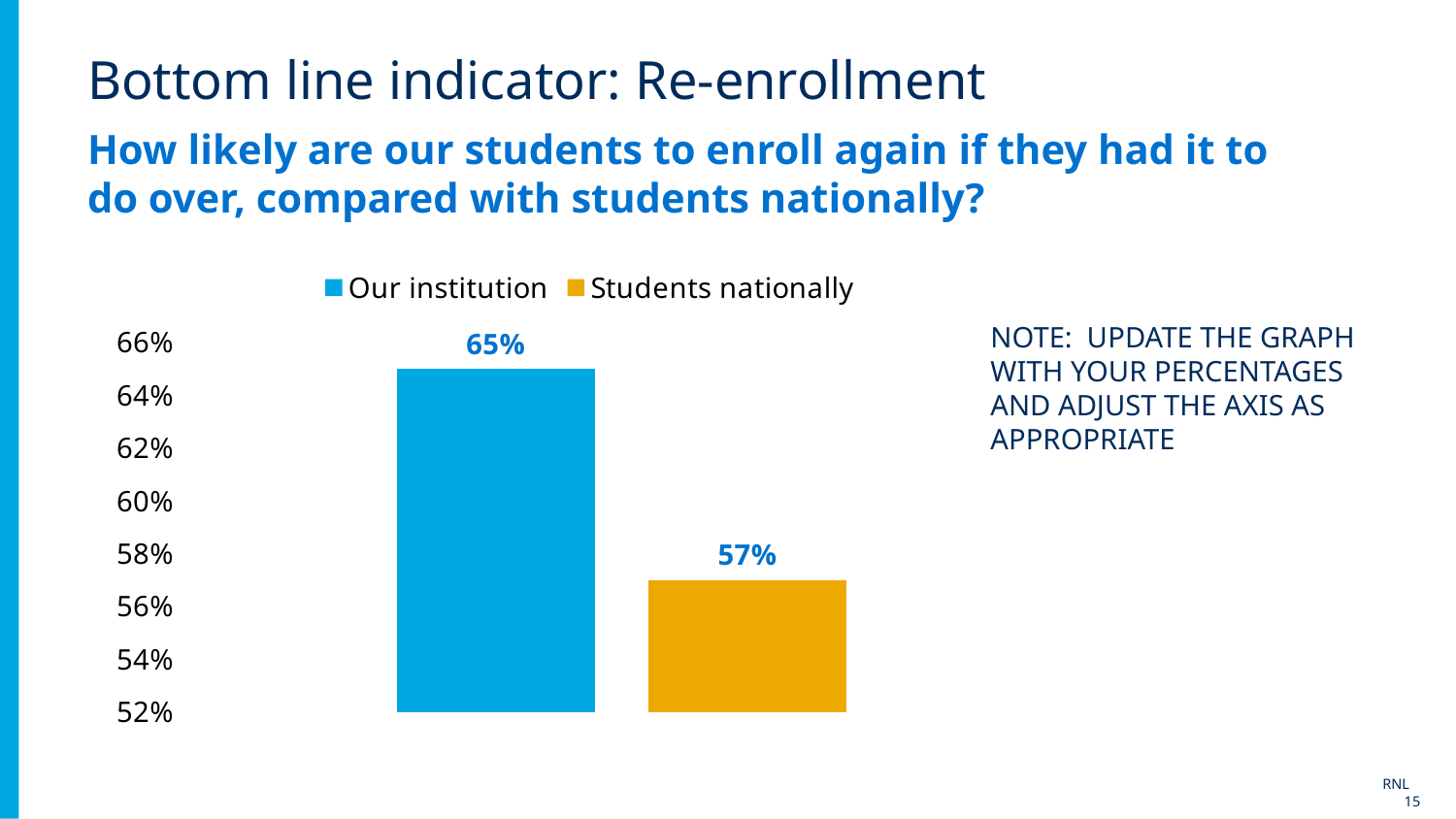
Which series has the lowest value? Students nationally Which is larger, the value for Our institution or the value for Students nationally? Our institution Is the value for Students nationally greater or less than 60%? less What kind of chart is shown on the slide? Bar chart What is the value for Students nationally? 57% How many series does the legend list? 2 What colour is the bar for Students nationally? Yellow What is the value for Our institution? 65% Is the value for Our institution greater or less than 62%? greater What is the difference between the value for Our institution and the value for Students nationally? 8% How many bars are plotted on the chart? 2 Which series has the highest value? Our institution